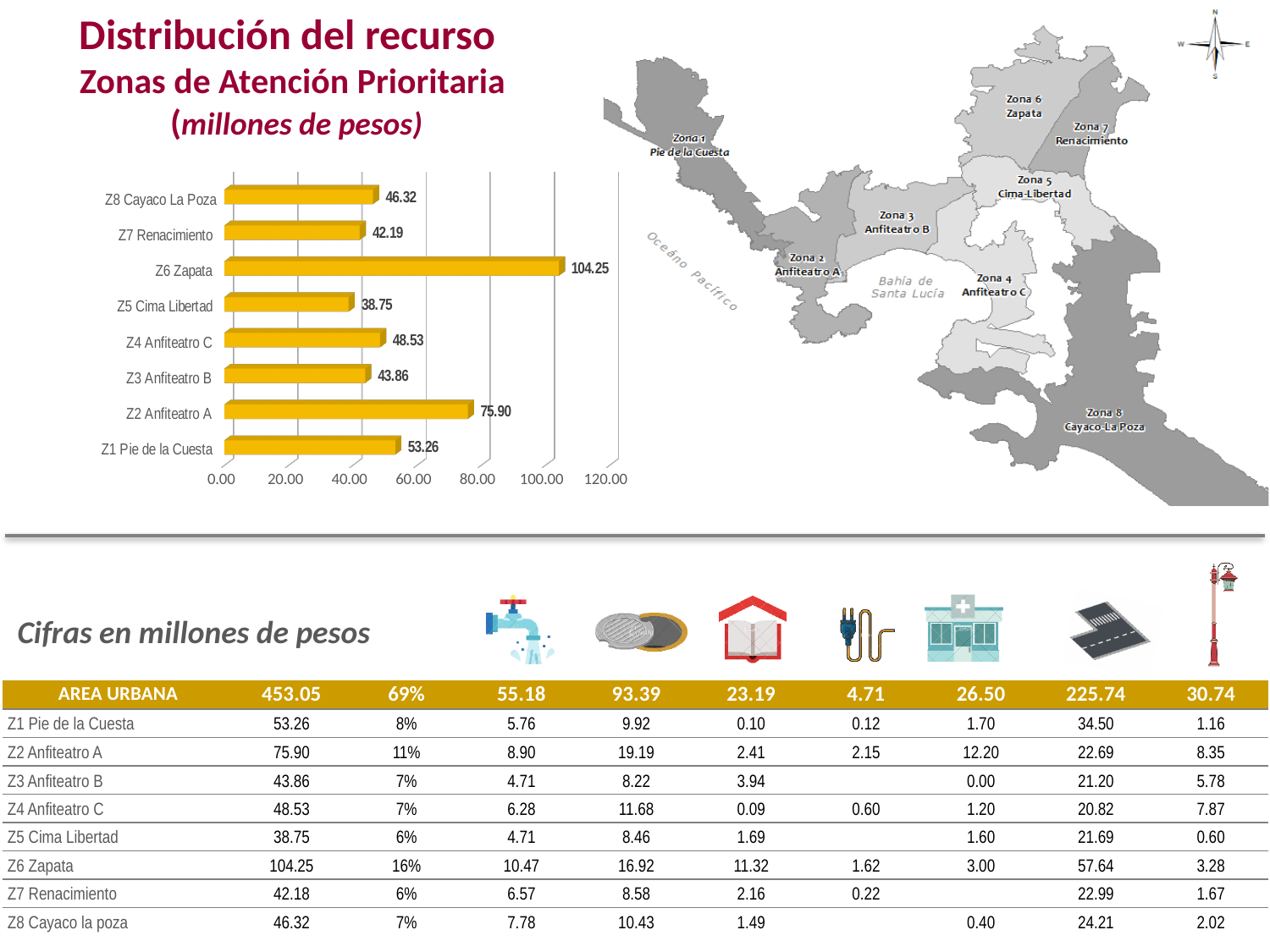
What is the value for Z6 Zapata in the bar chart? 104.25 What kind of chart is used to show the distribution of resources by zone? Bar chart How many zones are shown in the bar chart? 8 Which zone has the lowest value in the bar chart? Z5 Cima Libertad Is the value for Z2 Anfiteatro A in the bar chart greater or less than 60.00? greater What is the difference between the values for Z1 Pie de la Cuesta and Z8 Cayaco La Poza in the bar chart? 6.94 What is the difference between the values for Z6 Zapata and Z2 Anfiteatro A in the bar chart? 28.35 What is the value for Z7 Renacimiento in the bar chart? 42.19 What unit does the chart title say the values are in? millones de pesos Which has a larger value in the bar chart, Z4 Anfiteatro C or Z3 Anfiteatro B? Z4 Anfiteatro C What is the value for Z1 Pie de la Cuesta in the bar chart? 53.26 Which zone has the highest value in the bar chart? Z6 Zapata